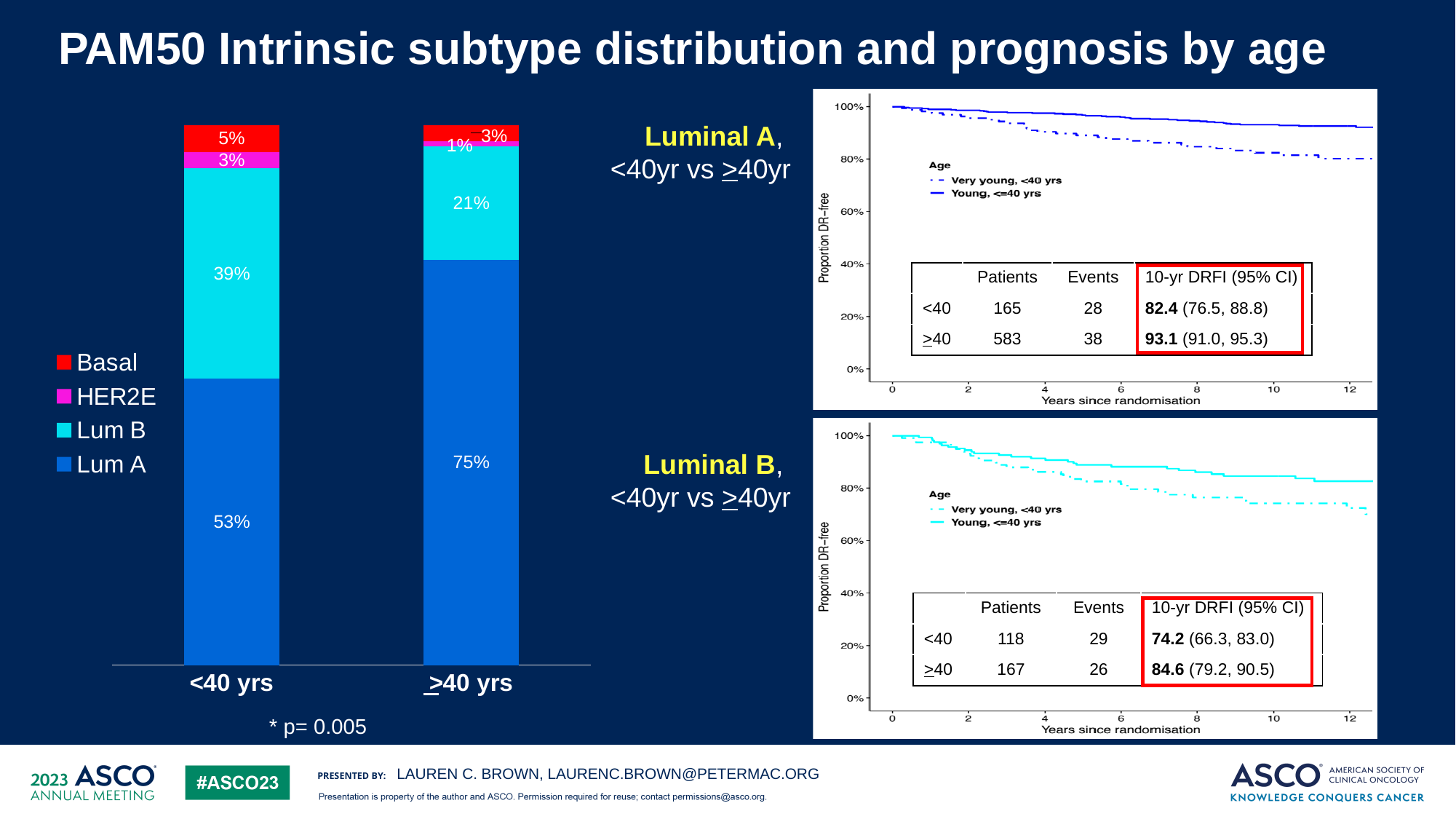
In the Luminal B chart on the bottom right, which age group has the higher 10-yr DRFI, <40 or >40? >40 In the stacked bar chart on the left, what percentage of the <40 yrs group is Basal? 5% How many subtypes does the legend of the stacked bar chart on the left list? 4 In the Luminal B chart on the bottom right, how many patients are in the >40 group? 167 What kind of chart is the chart on the left of the slide? Stacked bar chart In the stacked bar chart on the left, what percentage of the <40 yrs group is Lum A? 53% In the stacked bar chart on the left, which subtype has the smallest share in the >40 yrs group? HER2E How many age-group bars are shown in the stacked bar chart on the left? 2 In the Luminal A chart on the top right, what is the 10-yr DRFI for patients <40? 82.4 In the stacked bar chart on the left, what percentage of the >40 yrs group is Lum B? 21% In the stacked bar chart on the left, what is the difference in the Lum A share between the >40 yrs and <40 yrs groups? 22% In the stacked bar chart on the left, which age group has the larger Lum B share, <40 yrs or >40 yrs? <40 yrs